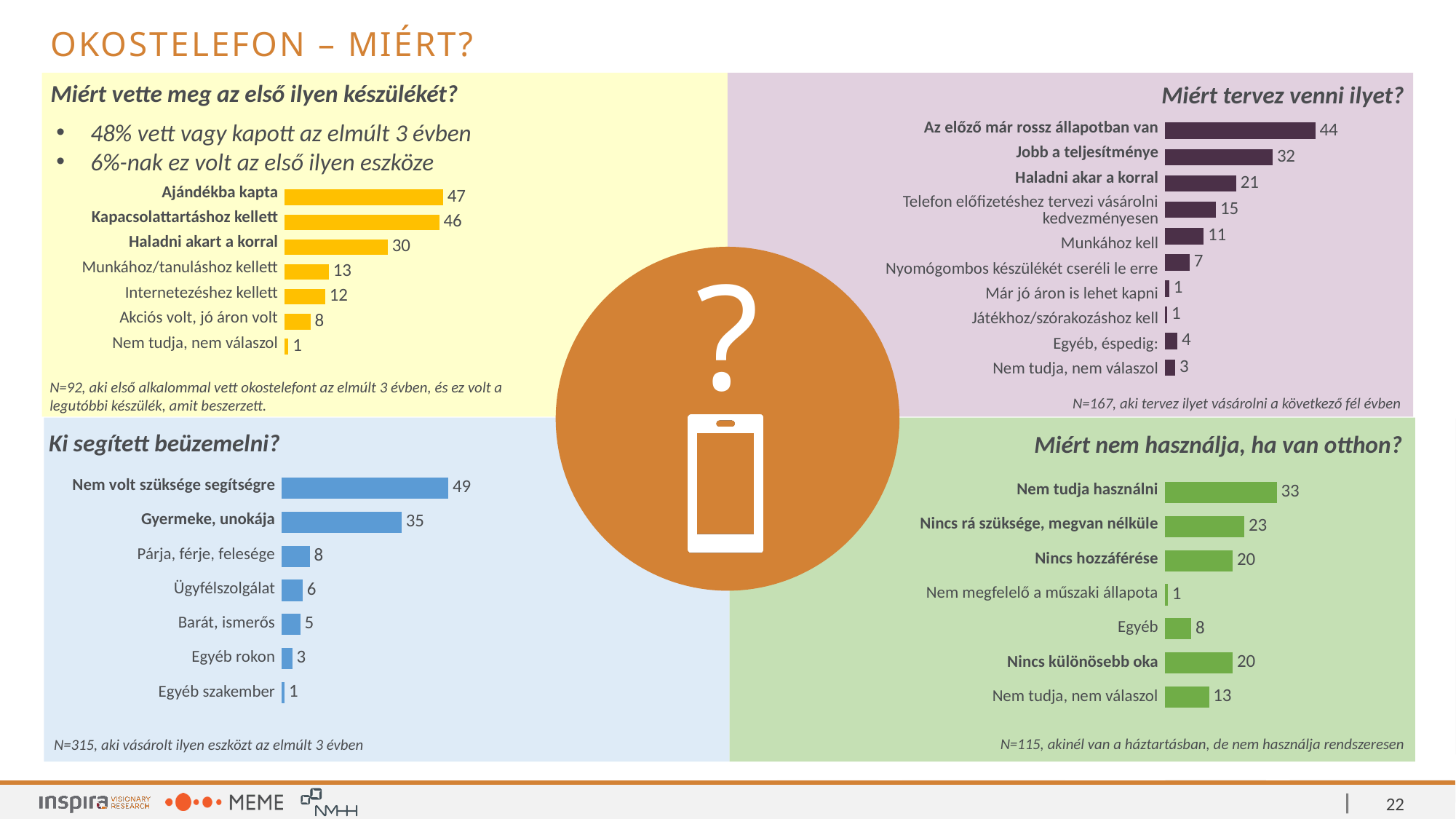
In the chart 'Ki segített beüzemelni?', which category has the lowest value? Egyéb szakember In the chart 'Miért vette meg az első ilyen készülékét?', what is the value for 'Haladni akart a korral'? 30 What type of chart is 'Miért nem használja, ha van otthon?'? Bar chart In the chart 'Miért vette meg az első ilyen készülékét?', how many categories are shown? 7 In the chart 'Miért tervez venni ilyet?', what is the value for 'Jobb a teljesítménye'? 32 In the chart 'Ki segített beüzemelni?', which is larger: 'Párja, férje, felesége' or 'Ügyfélszolgálat'? Párja, férje, felesége In the chart 'Miért vette meg az első ilyen készülékét?', which category has the highest value? Ajándékba kapta In the chart 'Miért tervez venni ilyet?', how many categories are shown? 10 In the chart 'Ki segített beüzemelni?', what is the value for 'Gyermeke, unokája'? 35 In the chart 'Miért tervez venni ilyet?', what is the difference between 'Az előző már rossz állapotban van' and 'Haladni akar a korral'? 23 In the chart 'Miért nem használja, ha van otthon?', what is the difference between 'Nincs rá szüksége, megvan nélküle' and 'Nem tudja, nem válaszol'? 10 In the chart 'Miért nem használja, ha van otthon?', what is the value for 'Nem tudja használni'? 33